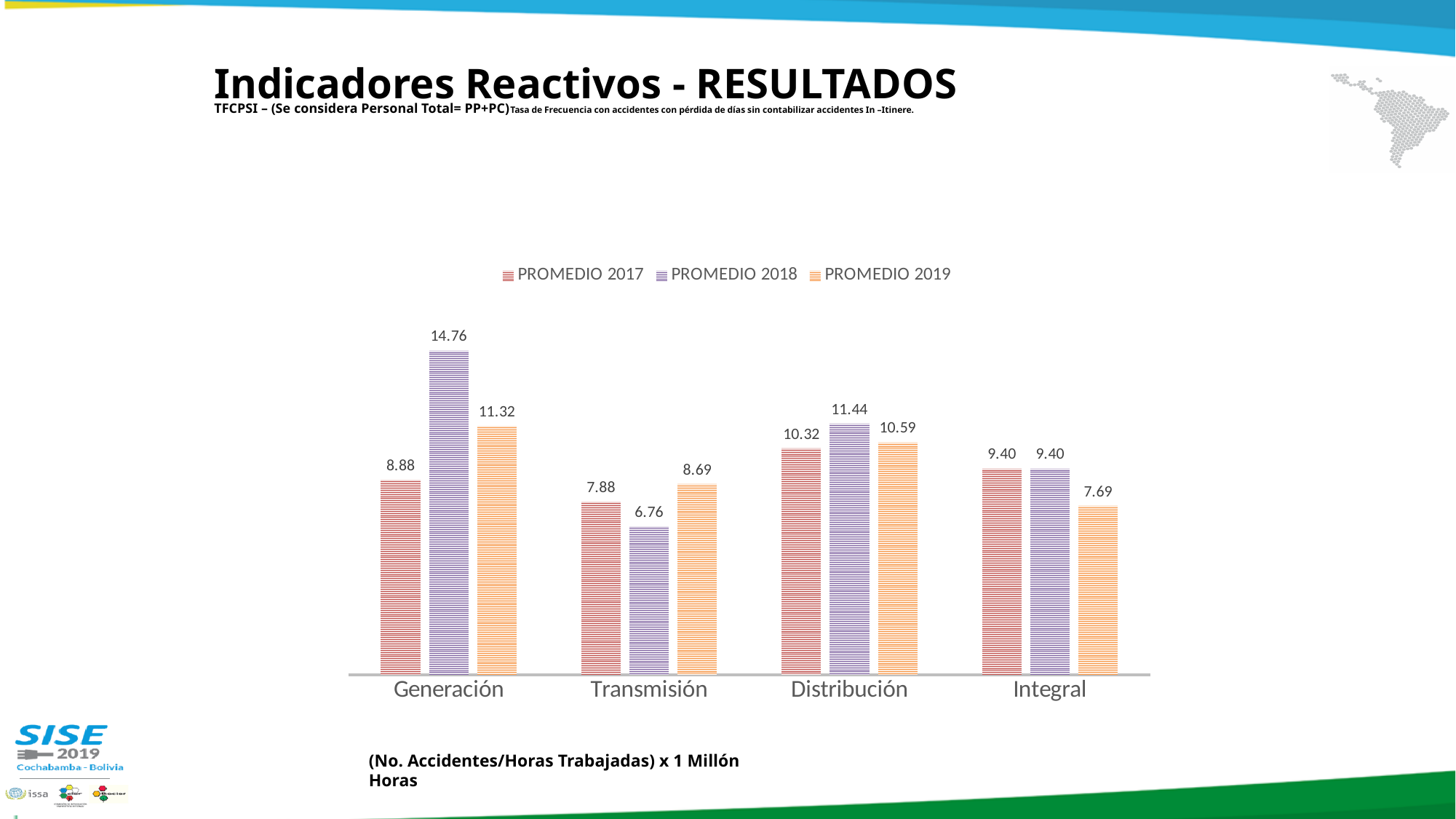
What is the PROMEDIO 2017 value for Distribución? 10.32 What is the difference between the PROMEDIO 2018 and PROMEDIO 2017 values for Generación? 5.88 What kind of chart is shown on the slide? Bar chart What is the PROMEDIO 2019 value for Integral? 7.69 What are the three series listed in the legend? PROMEDIO 2017, PROMEDIO 2018, PROMEDIO 2019 What is the PROMEDIO 2018 value for Generación? 14.76 How many series does the legend list? 3 Which category has the lowest PROMEDIO 2017 value? Transmisión What is the PROMEDIO 2019 value for Transmisión? 8.69 Which is larger for Transmisión, the PROMEDIO 2017 value or the PROMEDIO 2018 value? PROMEDIO 2017 How many categories are shown on the x axis? 4 Which category has the highest PROMEDIO 2018 value? Generación